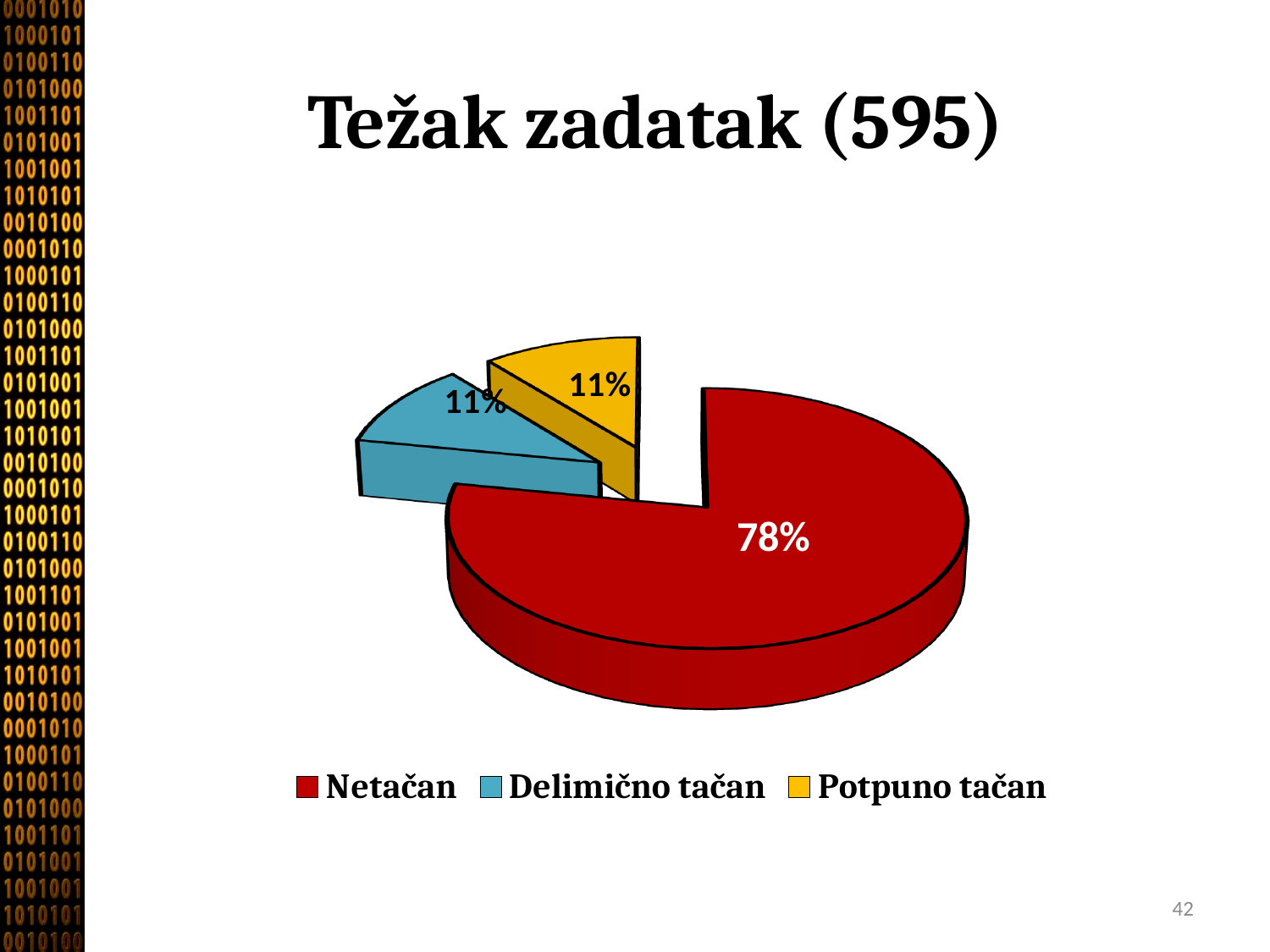
Which category has the largest slice of the pie? Netačan What share of the pie does Netačan take? 78% Is the value for Netačan greater or less than 50%? greater What is the value shown for Potpuno tačan? 11% What is the difference in percentage points between Netačan and Potpuno tačan? 67 What is the title of the chart? Težak zadatak (595) What kind of chart is shown on the slide? pie chart Which colour represents Netačan in the chart? red How many slices does the pie chart have? 3 What is the value shown for Delimično tačan? 11% Which is larger, the slice for Netačan or the slice for Delimično tačan? Netačan How many entries does the legend list? 3